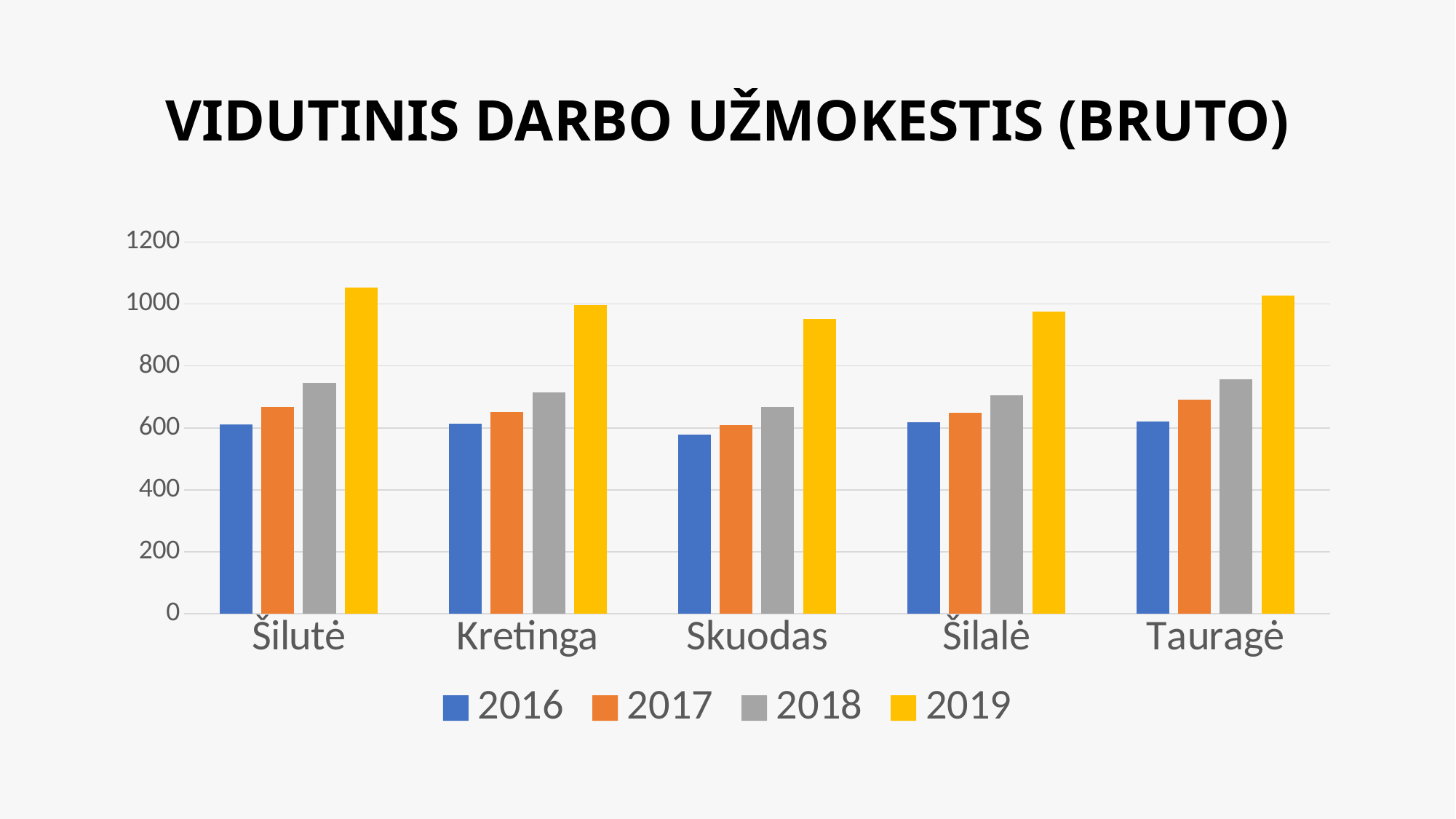
What kind of chart is shown on the slide? bar chart For Šilutė, do the values rise or fall from 2016 to 2019? rise Which colour represents the 2019 series in the legend? yellow How many series does the legend list? 4 Is the 2019 value for Šilutė greater or less than 1000? greater Is the 2019 value for Skuodas greater or less than 1000? less Is the 2016 value for Skuodas greater or less than 600? less What is the title of the chart? VIDUTINIS DARBO UŽMOKESTIS (BRUTO) How many categories are shown on the x axis? 5 Which category has the lowest 2016 value? Skuodas Which is larger, the 2019 value for Šilutė or the 2019 value for Skuodas? Šilutė